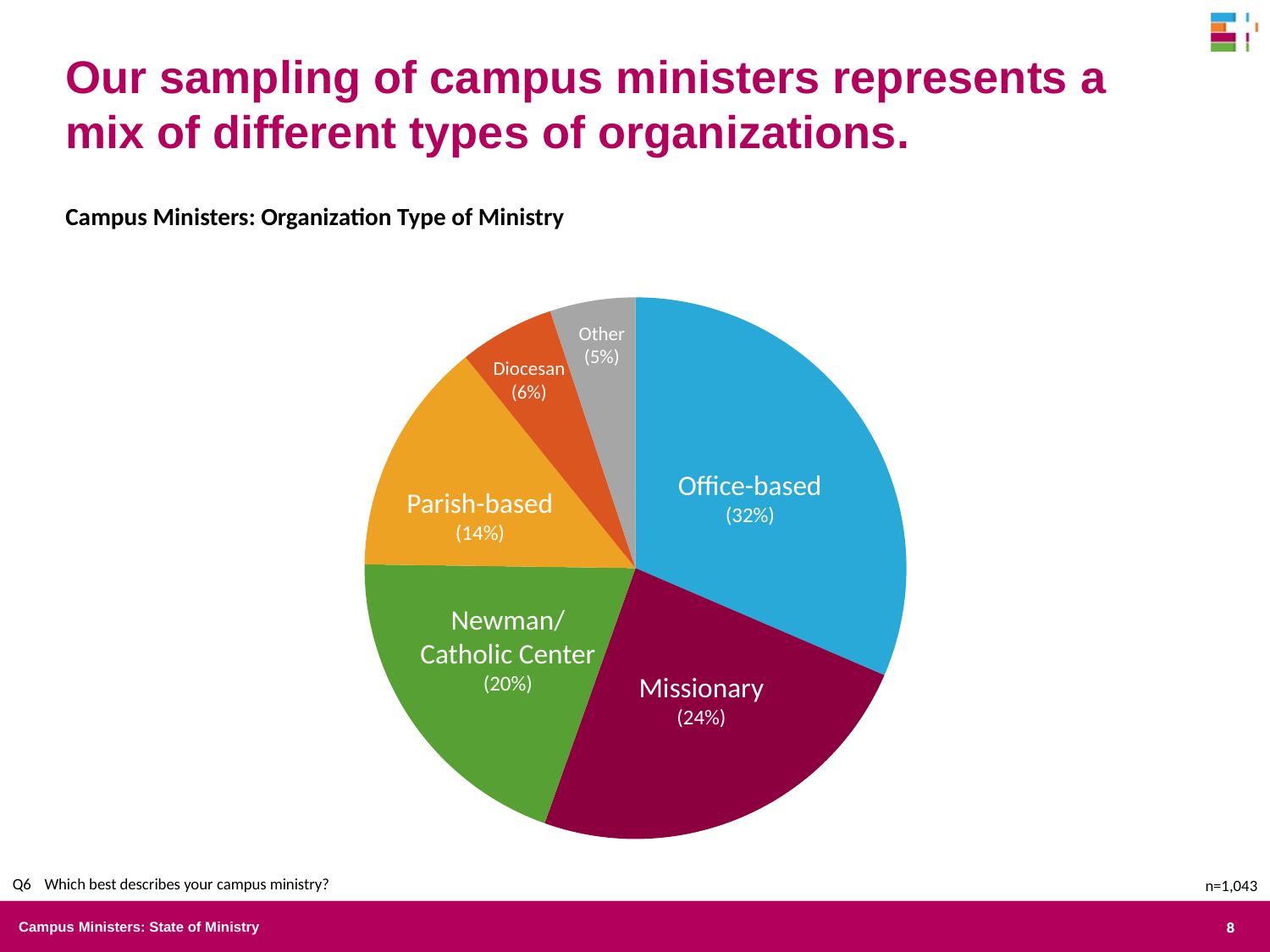
How many slices does the pie chart have? 6 Which organization type has the smallest share of the pie? Other What kind of chart is shown on the slide? pie chart What is the value for the Diocesan slice? 6% What is the title of the chart? Campus Ministers: Organization Type of Ministry What percentage of the pie is Missionary? 24% Which is larger, Parish-based or Newman/Catholic Center? Newman/Catholic Center What percentage is shown for Parish-based? 14% What share of campus ministers are Office-based? 32% What is the difference in percentage points between Office-based and Missionary? 8 What is the value for Newman/Catholic Center? 20% Which organization type has the largest share of the pie? Office-based